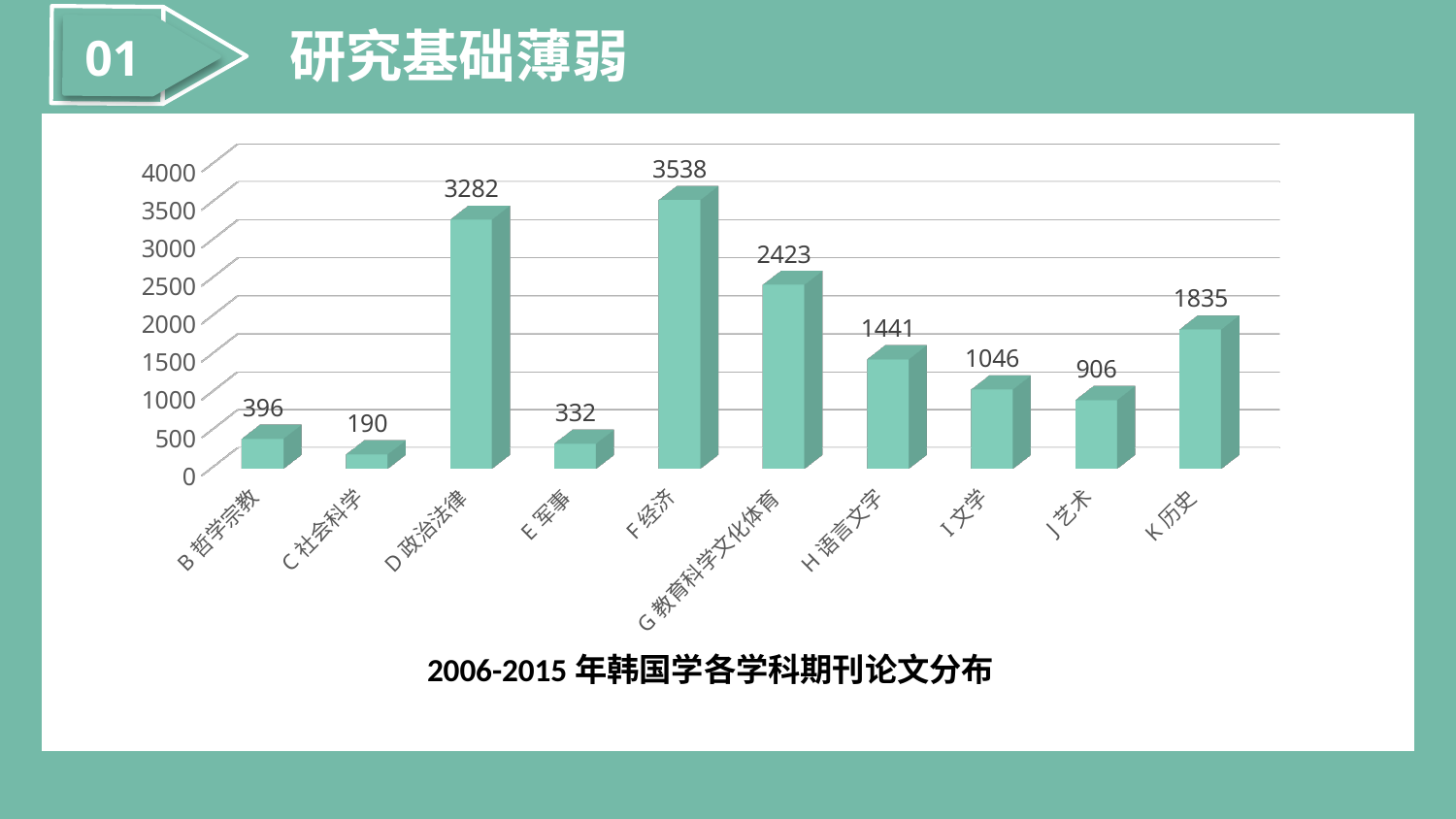
What is the difference between the values for F 经济 and D 政治法律? 256 Which category has the highest value? F 经济 What is the value for K 历史? 1835 Which category has the lowest value? C 社会科学 What is the caption below the chart? 2006-2015 年韩国学各学科期刊论文分布 How many categories are shown on the x axis? 10 What is the difference between the values for B 哲学宗教 and E 军事? 64 What is the value for D 政治法律? 3282 What is the value for F 经济? 3538 Is the value for G 教育科学文化体育 greater or less than 2000? greater Which is larger, the value for H 语言文字 or the value for I 文学? H 语言文字 What kind of chart is shown on the slide? bar chart